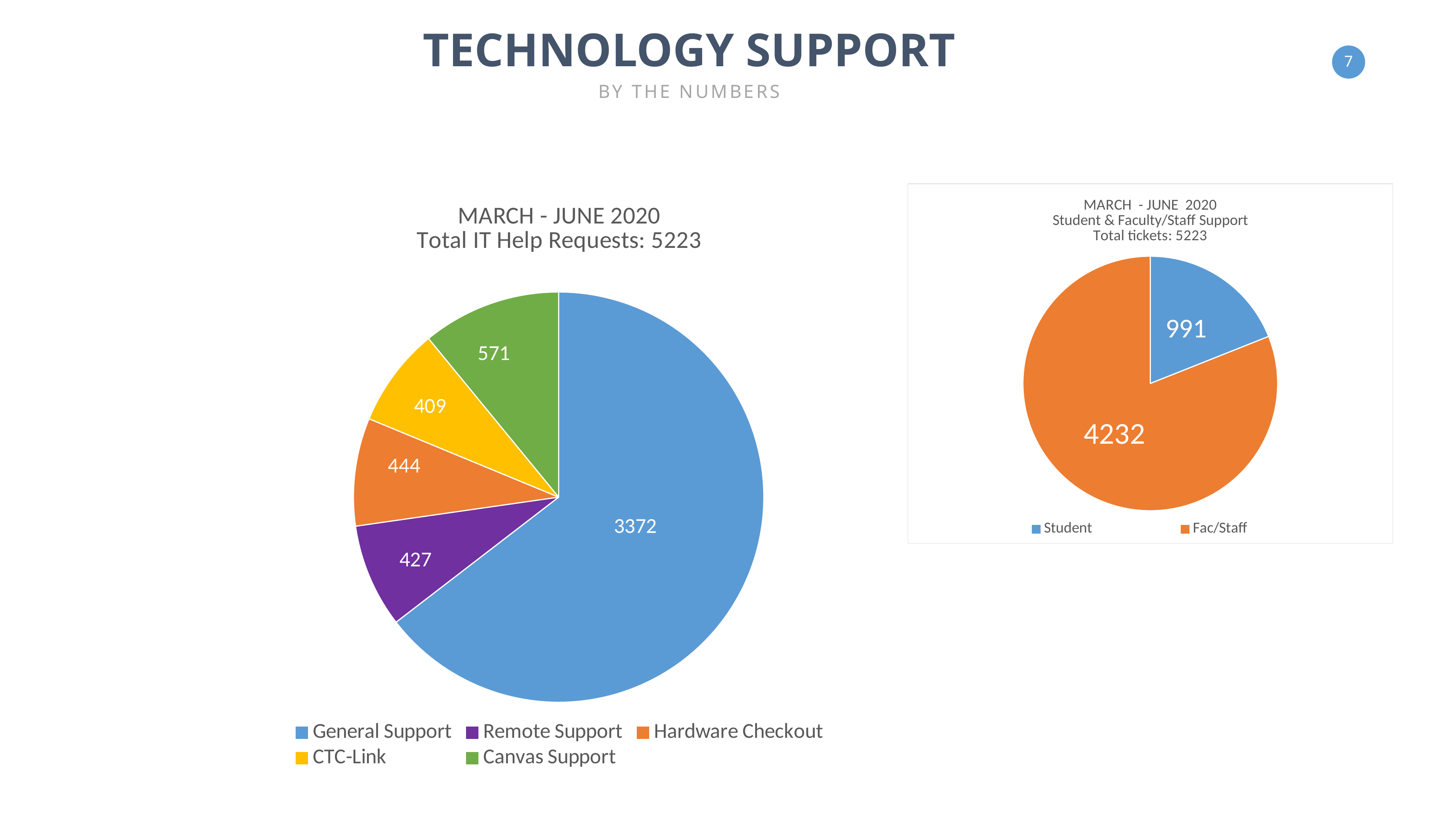
In the Total IT Help Requests pie chart, what is the value for Canvas Support? 571 In the Student & Faculty/Staff Support pie chart, what is the value for Student? 991 In the Total IT Help Requests pie chart, what is the value for Hardware Checkout? 444 What type of chart is used on the right side of the slide? Pie chart In the Total IT Help Requests pie chart, which category has the smallest slice? CTC-Link In the Student & Faculty/Staff Support pie chart, what is the difference between Fac/Staff and Student? 3241 In the Student & Faculty/Staff Support pie chart, what is the value for Fac/Staff? 4232 In the Total IT Help Requests pie chart, how many categories are shown? 5 In the Total IT Help Requests pie chart, what is the difference between General Support and Canvas Support? 2801 In the Student & Faculty/Staff Support pie chart, what share of the total tickets (5223) is Student? 19.0% In the Total IT Help Requests pie chart, which category has the largest slice? General Support In the Total IT Help Requests pie chart, what is the value for General Support? 3372